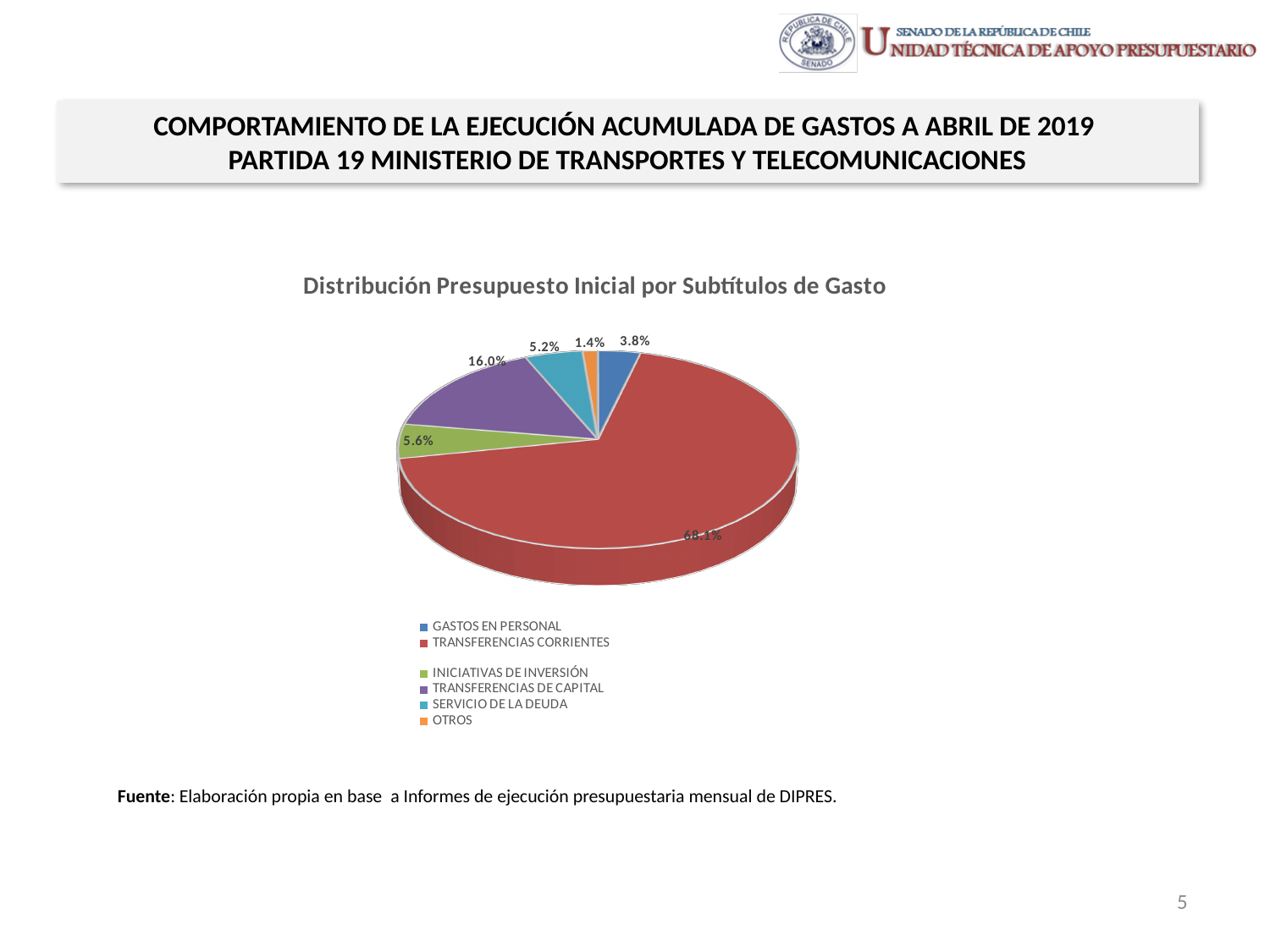
What kind of chart is shown on the slide? pie chart What is the difference between the shares of TRANSFERENCIAS DE CAPITAL and GASTOS EN PERSONAL? 12.2% What is the title of the chart? Distribución Presupuesto Inicial por Subtítulos de Gasto What is the value shown for GASTOS EN PERSONAL? 3.8% How many categories does the legend of the pie chart list? 6 Which category has the smallest slice of the pie? OTROS What is the value shown for INICIATIVAS DE INVERSIÓN? 5.6% Which is larger, the share for INICIATIVAS DE INVERSIÓN or the share for OTROS? INICIATIVAS DE INVERSIÓN What share of the pie does TRANSFERENCIAS DE CAPITAL represent? 16.0% What share of the pie does TRANSFERENCIAS CORRIENTES represent? 68.1% Which category has the largest slice of the pie? TRANSFERENCIAS CORRIENTES What is the value shown for SERVICIO DE LA DEUDA? 5.2%